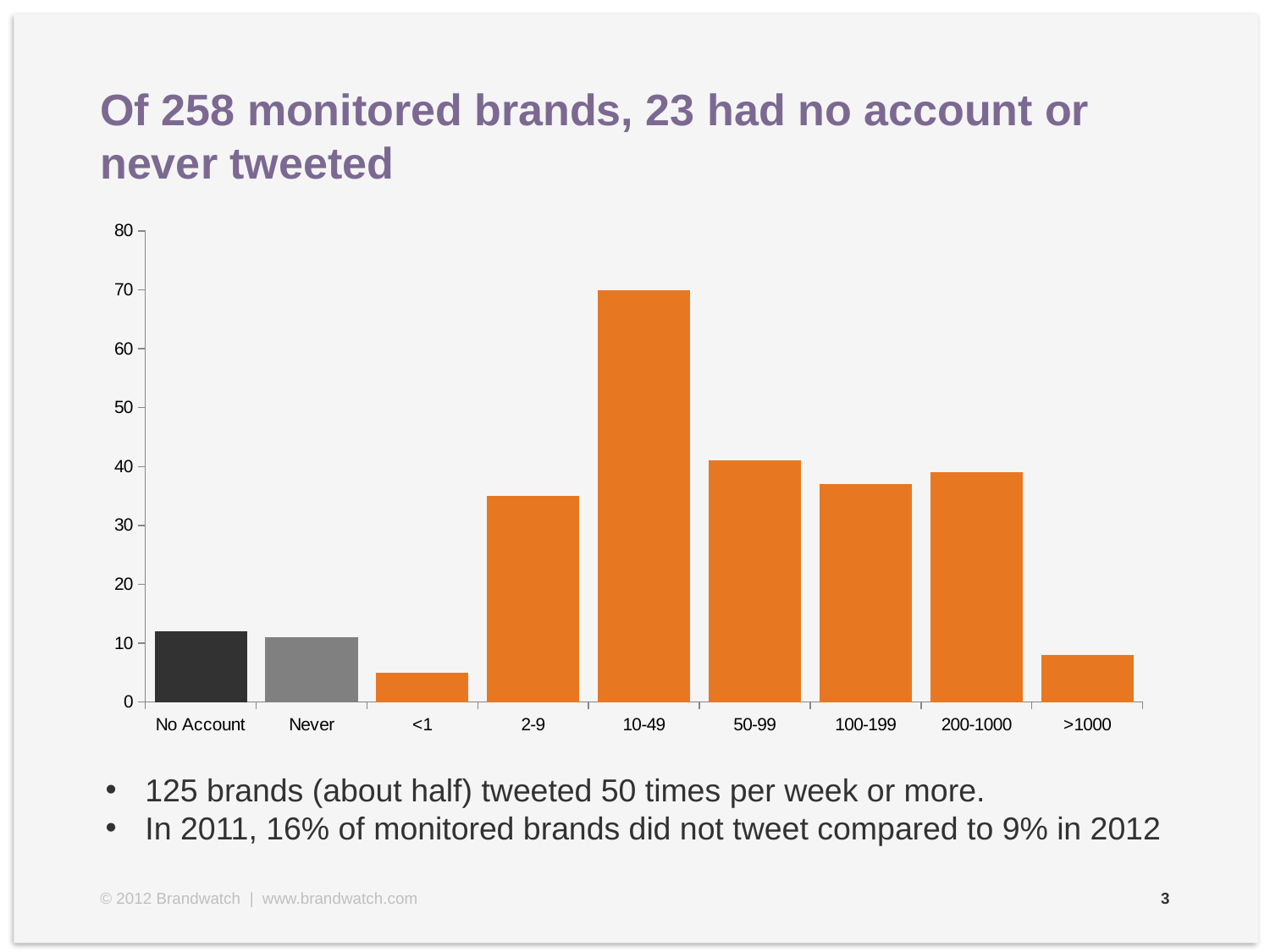
How many categories are shown on the x axis of the chart? 9 What kind of chart is shown on the slide? bar chart Which category has the lowest bar in the chart? <1 Which category's bar is coloured black in the chart? No Account Which is larger, the value for <1 or the value for Never? Never Is the value for 10-49 greater or less than 60? greater Which is larger, the value for 2-9 or the value for 50-99? 50-99 Is the value for No Account greater or less than 20? less Is the value for 2-9 greater or less than 30? greater Which category has the highest bar in the chart? 10-49